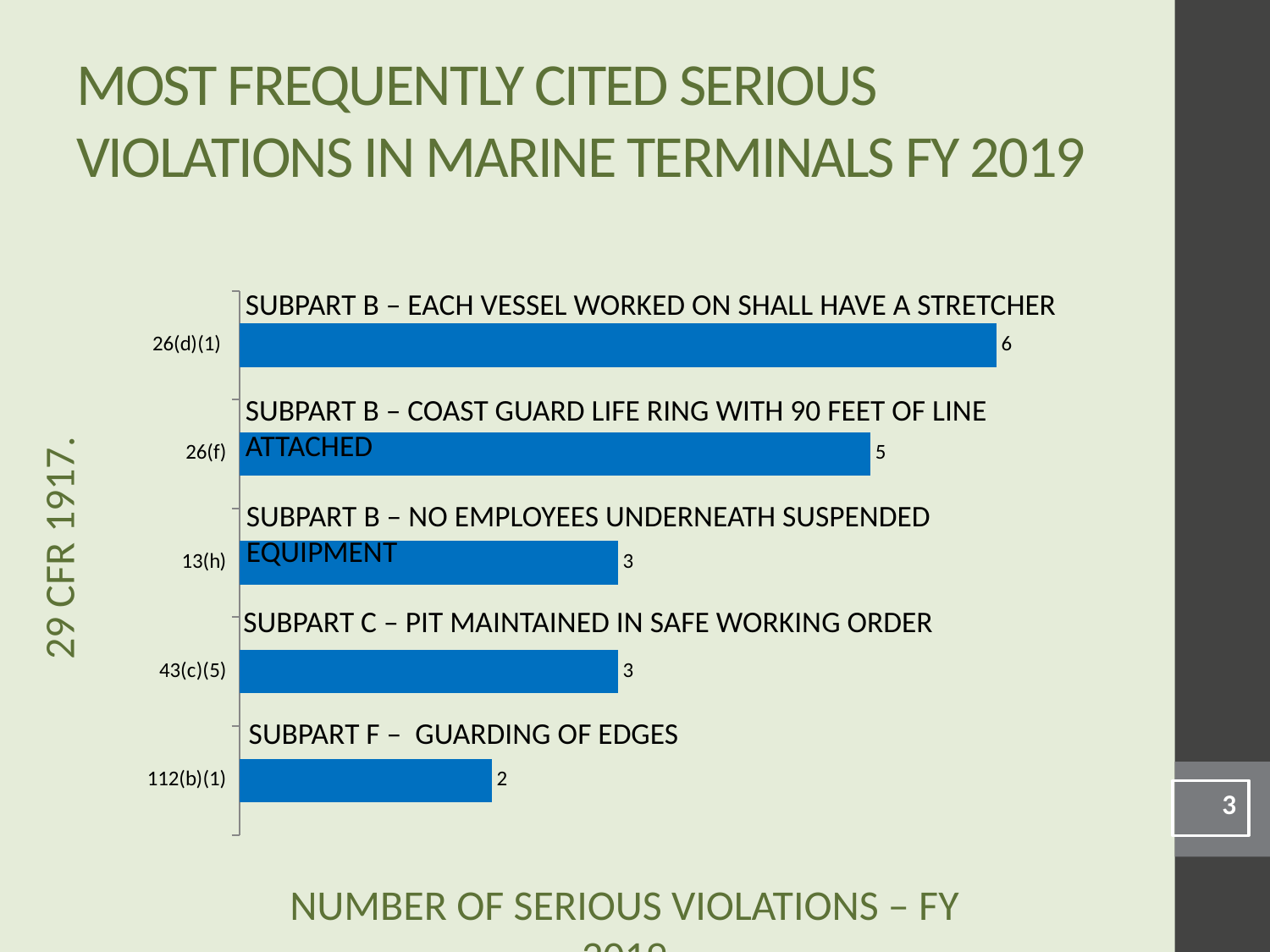
What is the number of serious violations for 112(b)(1)? 2 Which has a larger value, 26(f) or 43(c)(5)? 26(f) What is the label on the vertical axis of the chart? 29 CFR 1917. What is the number of serious violations for 13(h)? 3 Which category has the lowest number of serious violations? 112(b)(1) What is the difference between the values for 26(f) and 112(b)(1)? 3 What kind of chart is shown on the slide? Bar chart What is the number of serious violations for 26(d)(1)? 6 What is the difference between the values for 26(d)(1) and 26(f)? 1 What is the number of serious violations for 26(f)? 5 How many categories are shown in the chart? 5 Which category has the highest number of serious violations? 26(d)(1)